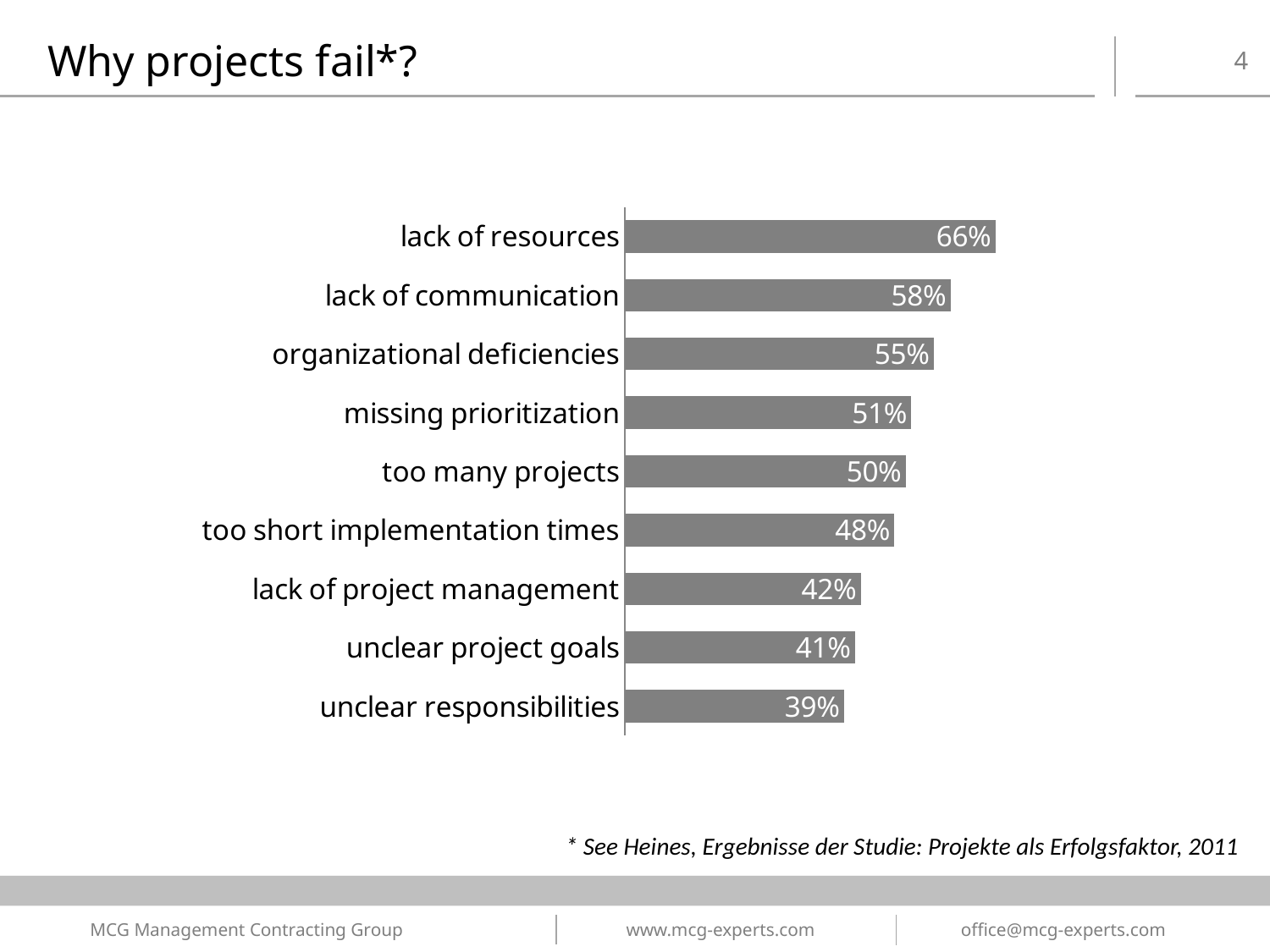
What is the value for missing prioritization? 51% Which category has the highest value? lack of resources What is the value for unclear project goals? 41% What is the title of the slide containing the chart? Why projects fail*? What is the value for too short implementation times? 48% What is the difference between lack of resources and unclear responsibilities? 27% What kind of chart is shown on the slide? bar chart Which is larger, organizational deficiencies or too many projects? organizational deficiencies What is the value for lack of resources? 66% Which category has the lowest value? unclear responsibilities What is the difference between lack of communication and lack of project management? 16% How many categories are shown in the chart? 9